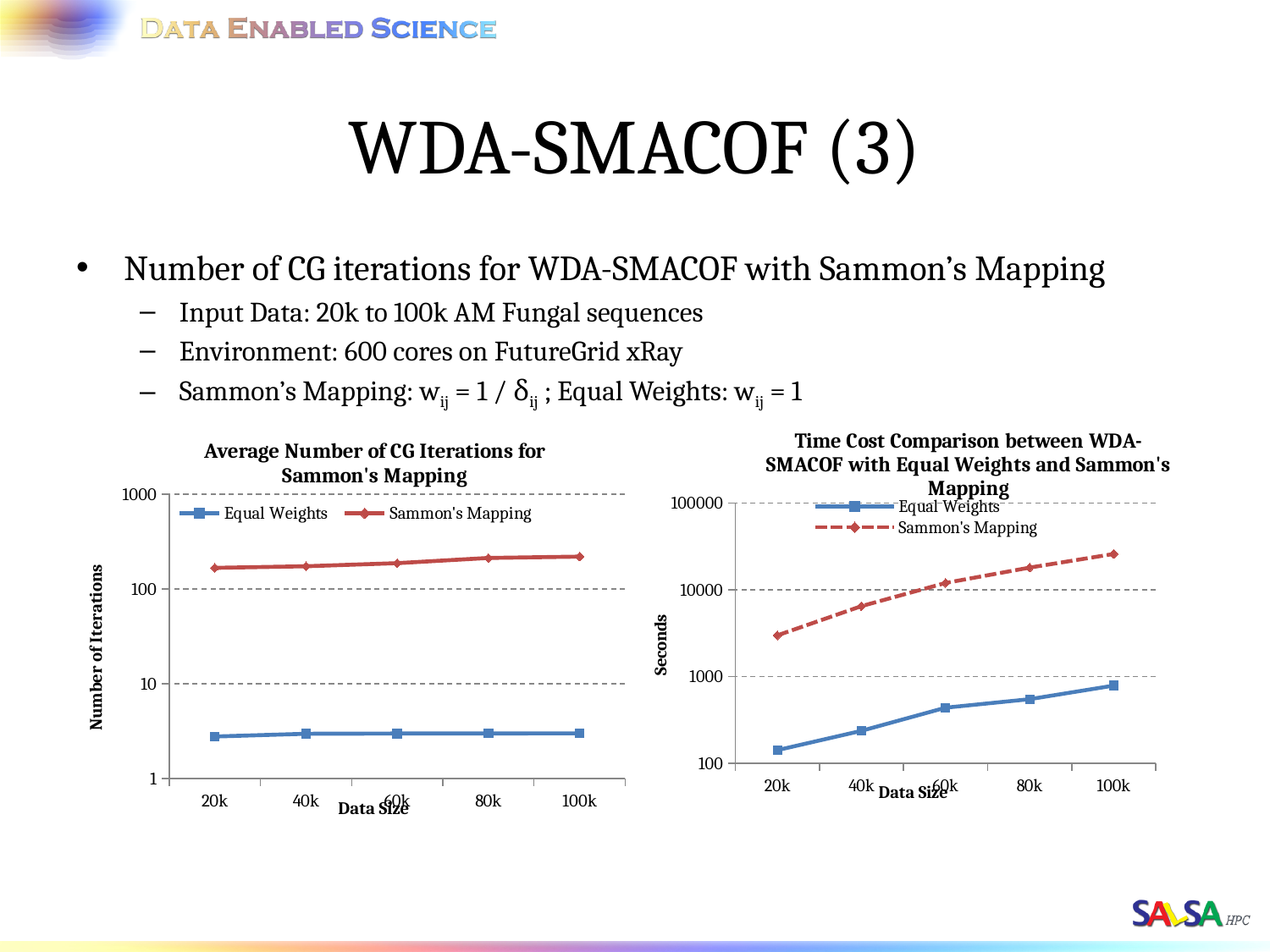
In the right chart, 'Time Cost Comparison', is the value for Sammon's Mapping at 100k greater or less than 10000? greater In the right chart, 'Time Cost Comparison', which series has the higher value at 60k, Equal Weights or Sammon's Mapping? Sammon's Mapping In the right chart, 'Time Cost Comparison', is the value for Sammon's Mapping at 20k greater or less than 1000? greater How many series does the legend of the right chart, 'Time Cost Comparison', list? 2 How many data sizes are plotted along the x axis of the left chart, 'Average Number of CG Iterations for Sammon's Mapping'? 5 What kind of chart is the left chart, 'Average Number of CG Iterations for Sammon's Mapping'? line chart In the right chart, 'Time Cost Comparison', do the values for Equal Weights rise or fall as data size increases from 20k to 100k? rise In the left chart, 'Average Number of CG Iterations for Sammon's Mapping', is the value for Equal Weights at 100k greater or less than 10? less What is the y-axis label of the right chart, 'Time Cost Comparison'? Seconds In the left chart, 'Average Number of CG Iterations for Sammon's Mapping', which series is drawn in red? Sammon's Mapping